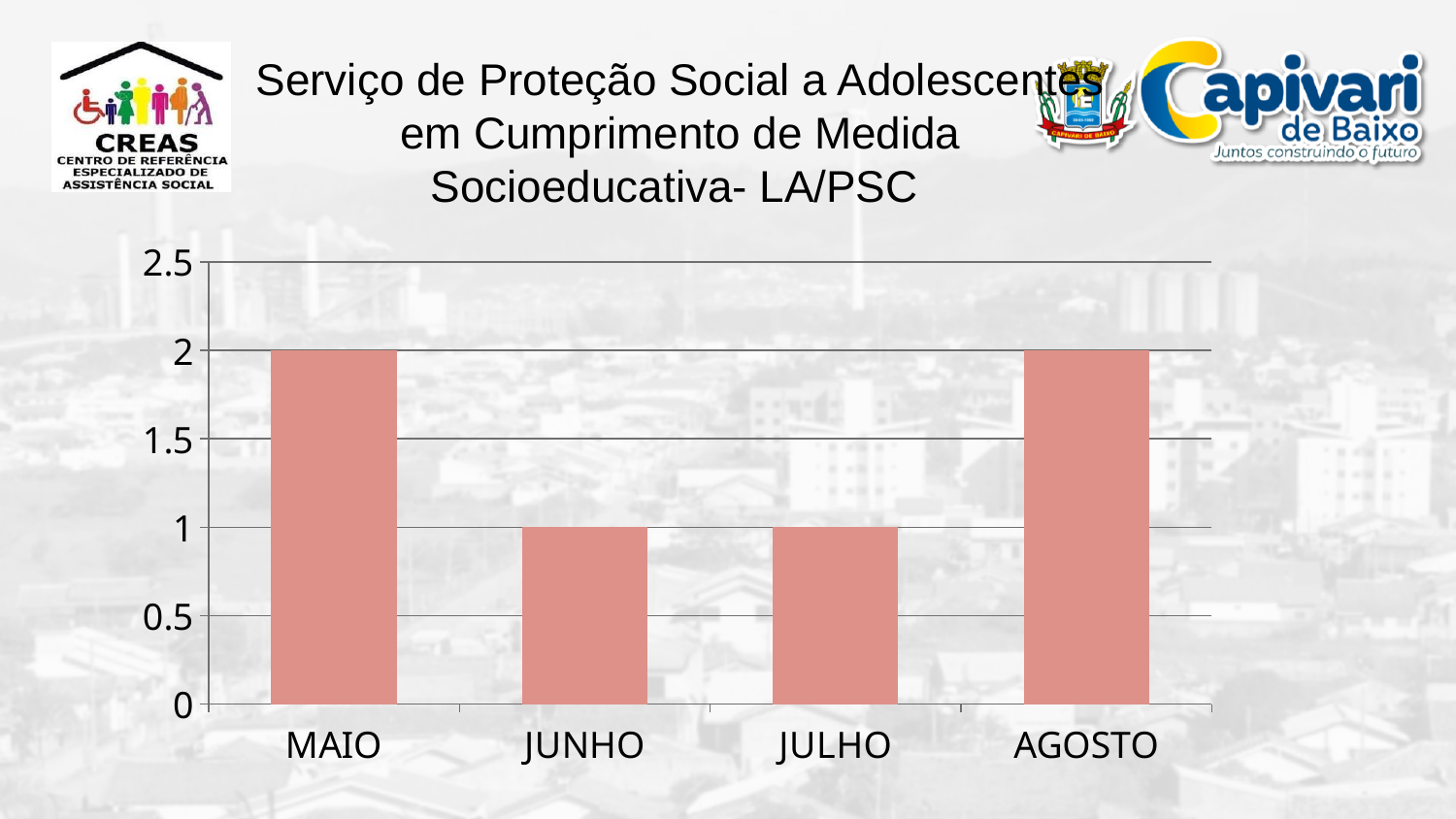
What is the value for JUNHO? 1 What is the difference between the values for MAIO and JUNHO? 1 Which months share the lowest value? JUNHO and JULHO Is the value for MAIO greater or less than 1.5? greater How many months are shown on the x axis? 4 What kind of chart is shown on the slide? bar chart What is the value for JULHO? 1 Which months share the highest value? MAIO and AGOSTO What is the value for AGOSTO? 2 Which is larger, the value for AGOSTO or the value for JULHO? AGOSTO What is the value for MAIO? 2 Does the value rise or fall from MAIO to JUNHO? fall